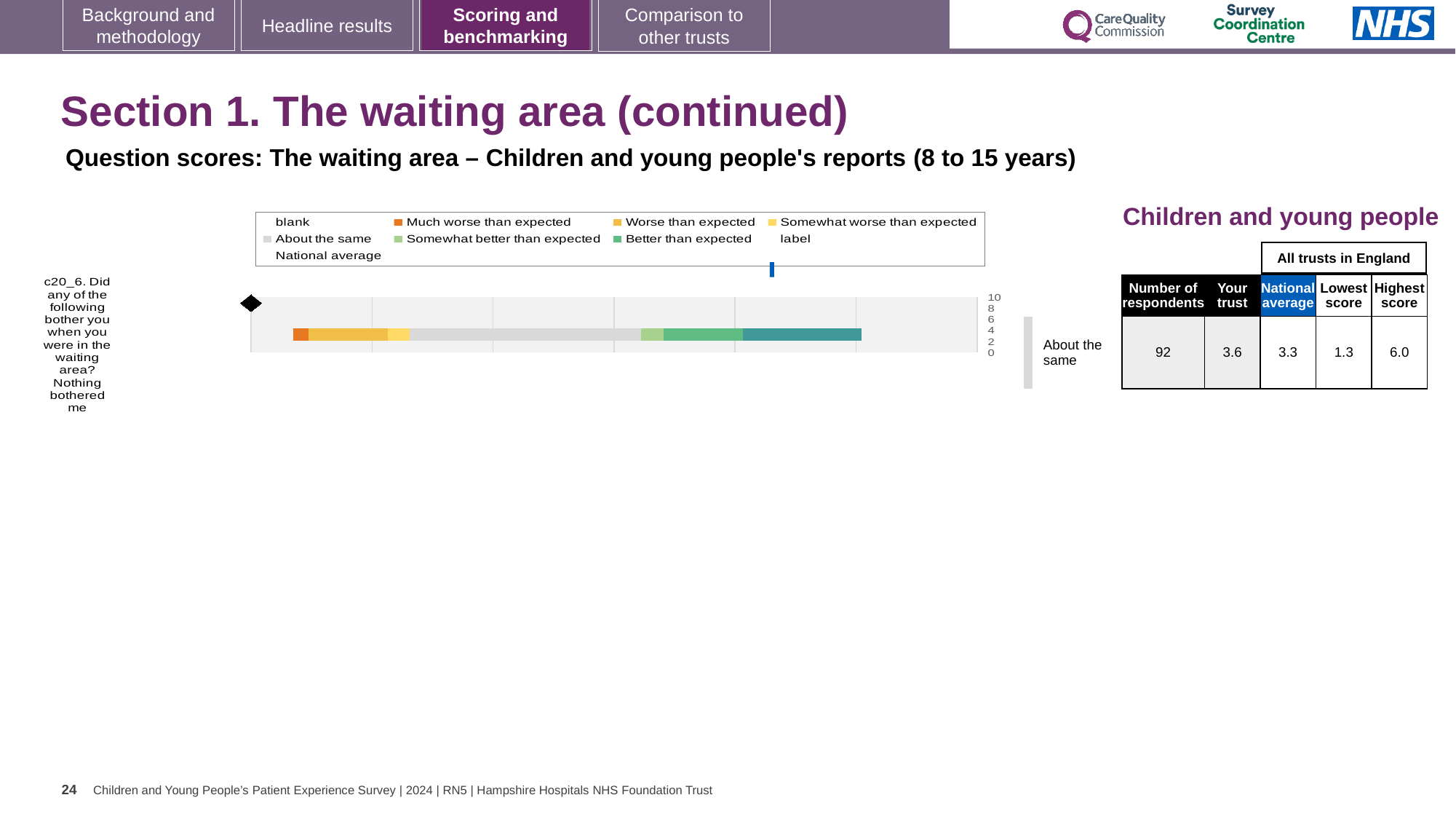
How many respondents are listed for question c20_6 in the Children and young people table? 92 How many survey questions are plotted as bars in the chart? 1 What colour is the 'Much worse than expected' segment in the chart legend? orange What is the highest score among all trusts in England for question c20_6? 6.0 What kind of chart is shown on the slide for question c20_6? bar chart What benchmark category label is shown to the right of the bar for question c20_6? About the same Which is larger for question c20_6, the 'Your trust' score or the national average? Your trust What is the national average score for question c20_6 in the Children and young people table? 3.3 What is the highest value shown on the chart's numeric axis? 10 What is the difference between the highest score and the lowest score for question c20_6? 4.7 What is the lowest score among all trusts in England for question c20_6? 1.3 What is the 'Your trust' score for question c20_6 in the Children and young people table? 3.6